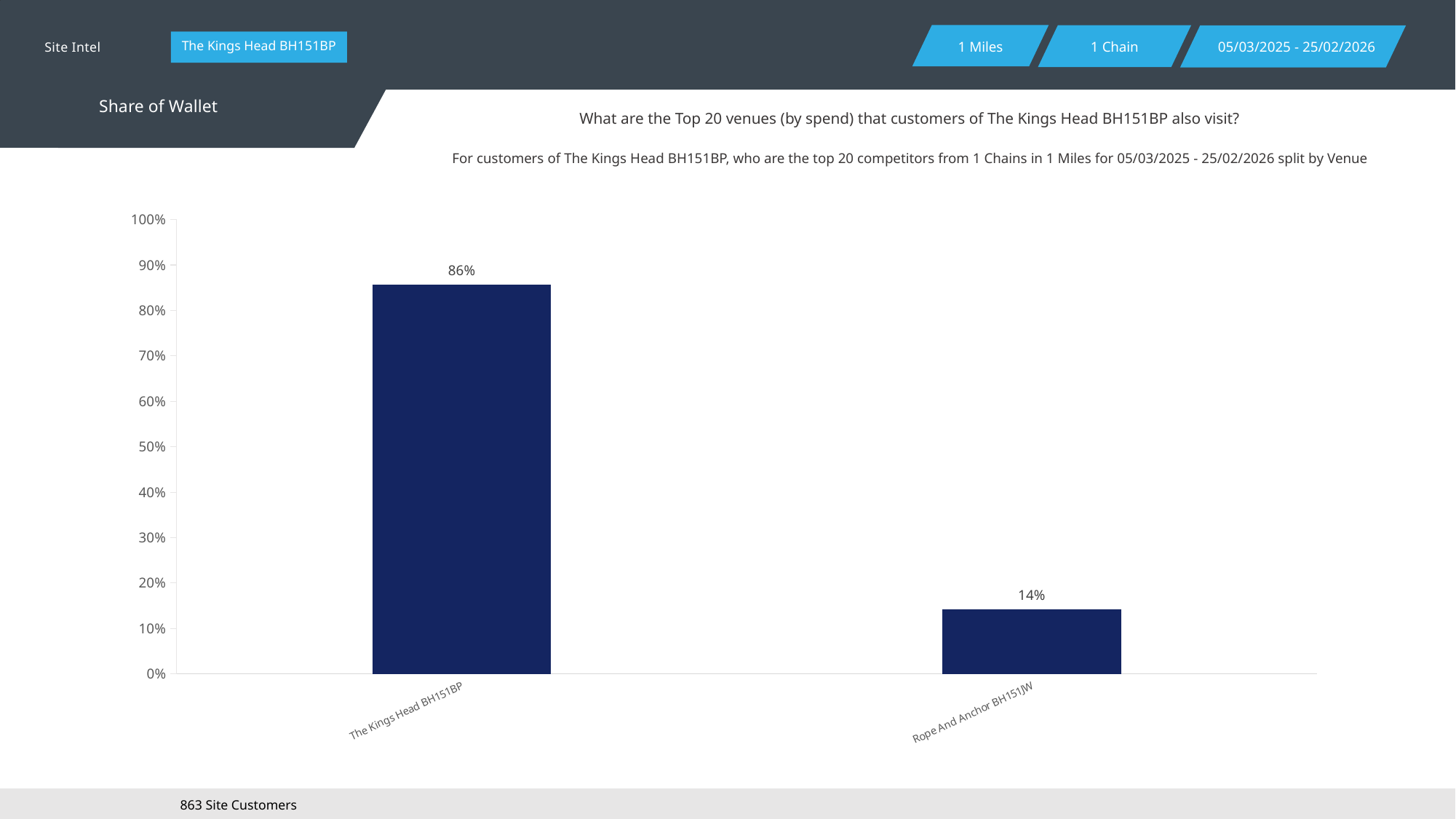
Is the value for The Kings Head BH151BP greater or less than 80%? greater What is the difference between the values for The Kings Head BH151BP and Rope And Anchor BH151JW? 72% What is the total of the two values shown on the chart? 100% What is the maximum value shown on the y axis? 100% What is the value for Rope And Anchor BH151JW? 14% How many venues are shown on the chart? 2 What kind of chart is shown on the slide? Bar chart Which venue has the highest share of wallet? The Kings Head BH151BP Which venue has the lowest share of wallet? Rope And Anchor BH151JW Which is larger, the value for The Kings Head BH151BP or the value for Rope And Anchor BH151JW? The Kings Head BH151BP What is the value for The Kings Head BH151BP? 86% Is the value for Rope And Anchor BH151JW greater or less than 20%? less